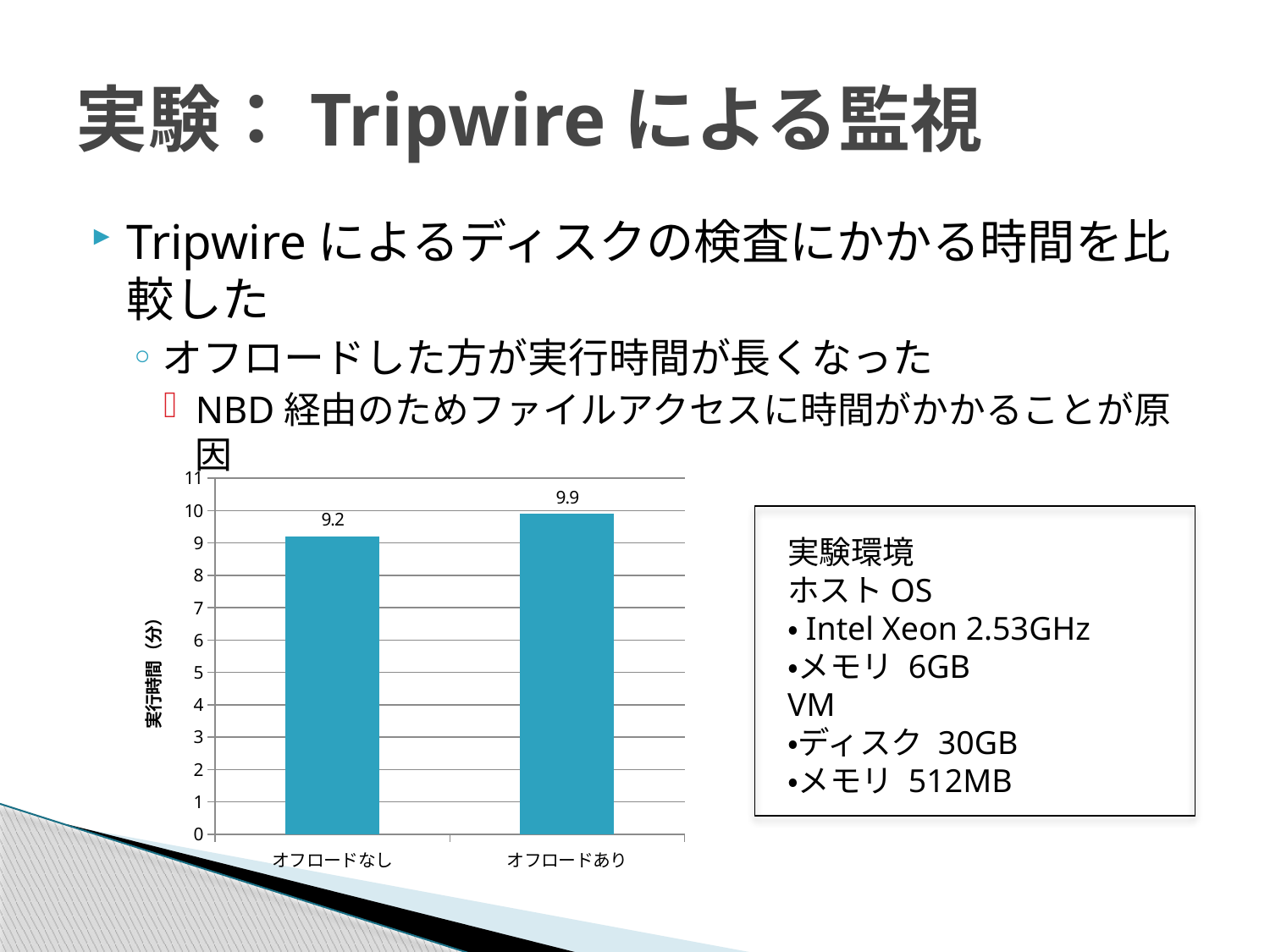
What is the difference between the values for オフロードあり and オフロードなし? 0.7 Is the value for オフロードあり greater or less than 9? greater Which category has the lowest value? オフロードなし What kind of chart is shown on the slide? bar chart Do the values rise or fall from オフロードなし to オフロードあり? rise Which category has the highest value? オフロードあり Is the value for オフロードなし greater or less than 10? less What is the label of the y axis? 実行時間（分） What is the value for オフロードあり? 9.9 How many categories are shown on the x axis? 2 What is the value for オフロードなし? 9.2 Which is larger, the value for オフロードなし or オフロードあり? オフロードあり